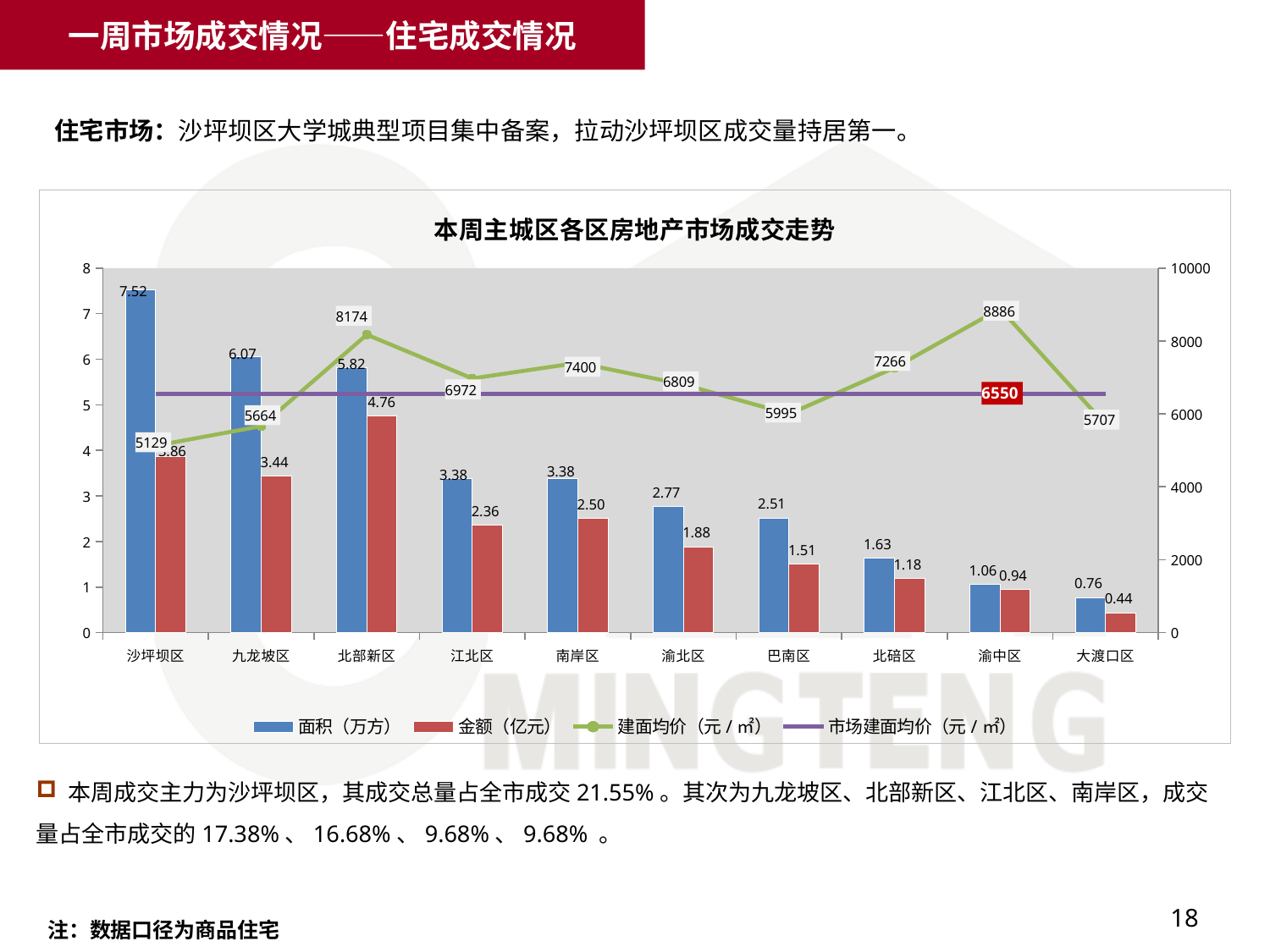
How many districts are shown on the x axis? 10 What is the 面积（万方） value for 沙坪坝区? 7.52 What is the 金额（亿元） value for 北部新区? 4.76 How many series does the legend list? 4 What kind of chart is this? Combined bar and line chart What is the difference between the 面积（万方） values for 沙坪坝区 and 九龙坡区? 1.45 Which is larger, the 金额（亿元） for 北部新区 or for 九龙坡区? 北部新区 Which district has the highest 建面均价（元/㎡）? 渝中区 Do the 面积（万方） values generally rise or fall from left to right along the x axis? Fall Which district has the lowest 金额（亿元）? 大渡口区 What is the 建面均价（元/㎡） value for 渝中区? 8886 What is the value of the 市场建面均价（元/㎡） line? 6550